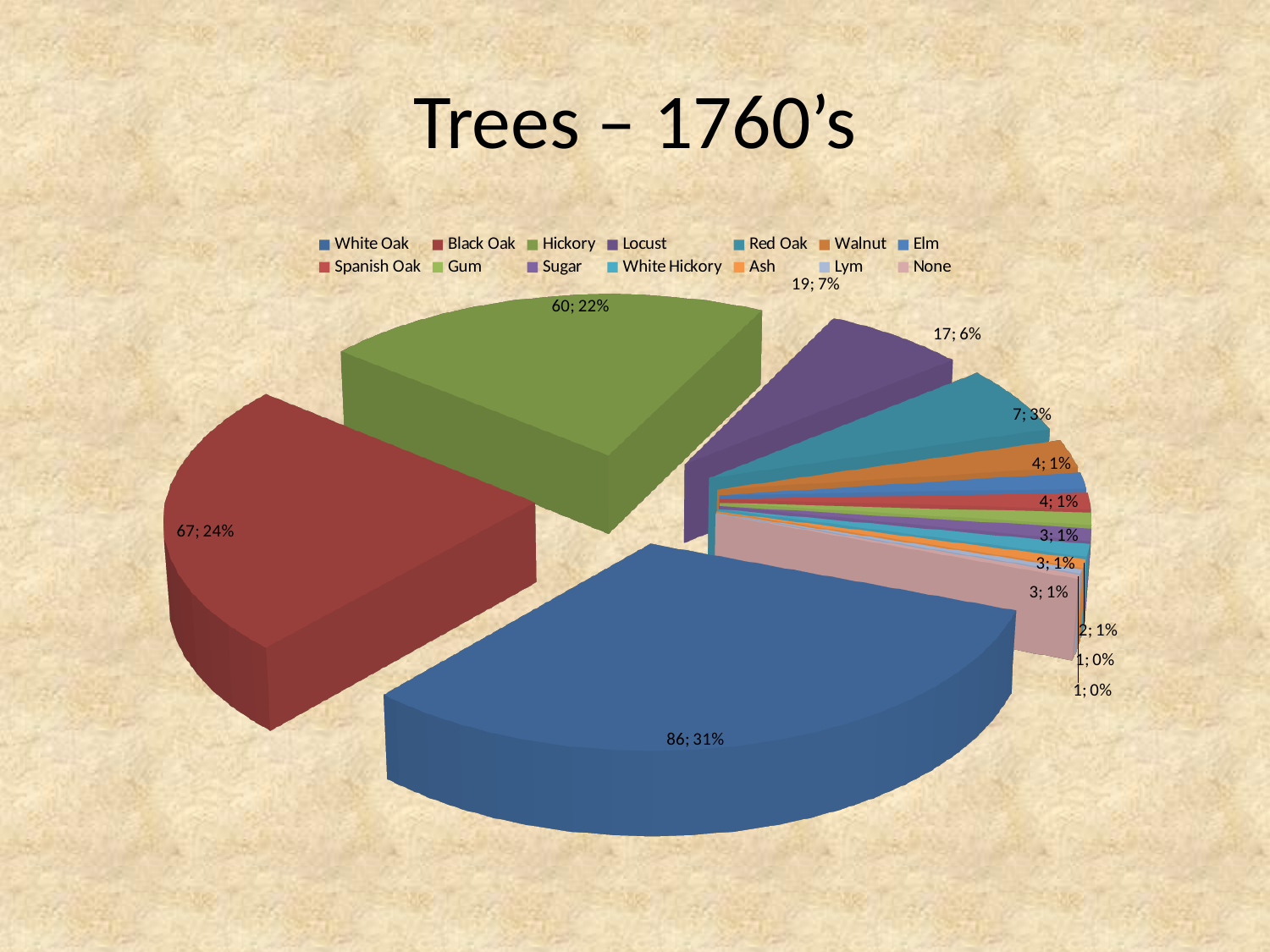
Which is larger, the Black Oak slice or the Hickory slice? Black Oak What colour is the White Oak slice? Blue How many categories does the legend list? 14 How many trees are recorded for Black Oak? 67 How many trees are recorded for White Oak? 86 What share of the pie does Locust represent? 7% Which category has the largest slice of the pie? White Oak What kind of chart is shown on the slide? Pie chart What is the title of the chart? Trees – 1760's What share of the pie does Hickory represent? 22% What share of the pie does White Oak represent? 31% What is the difference between the White Oak count and the Black Oak count? 19